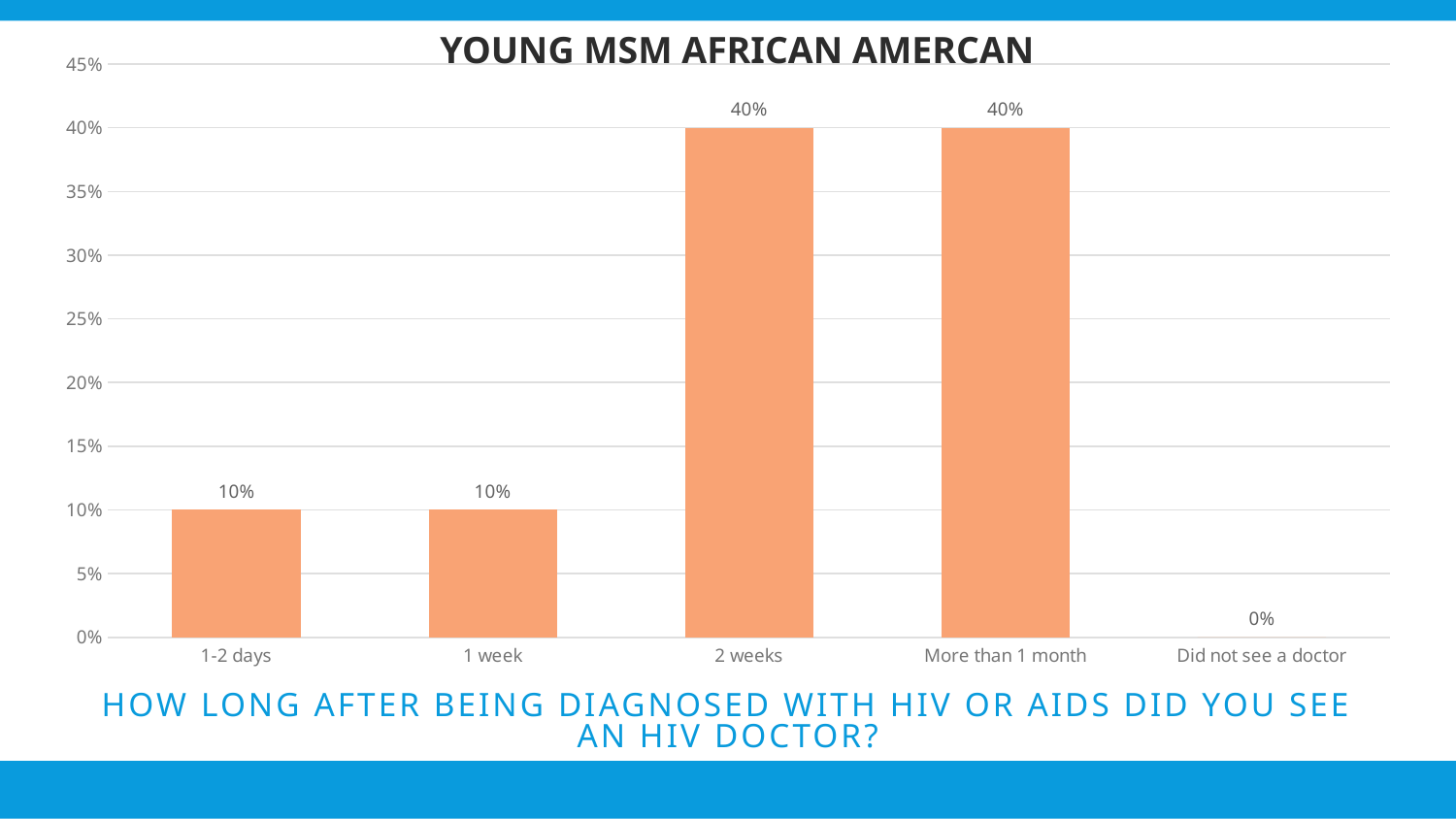
What is the value for More than 1 month? 40% Is the value for 2 weeks greater or less than 35%? greater What is the title of the chart? YOUNG MSM AFRICAN AMERCAN What is the difference between the values for 2 weeks and 1 week? 30% What is the value for Did not see a doctor? 0% What is the value for 1-2 days? 10% How many categories are shown on the x axis? 5 What kind of chart is shown on the slide? bar chart What is the value for 2 weeks? 40% What is the highest value shown on the y axis? 45% Which is larger, the value for 1 week or the value for More than 1 month? More than 1 month Which category has the lowest value? Did not see a doctor